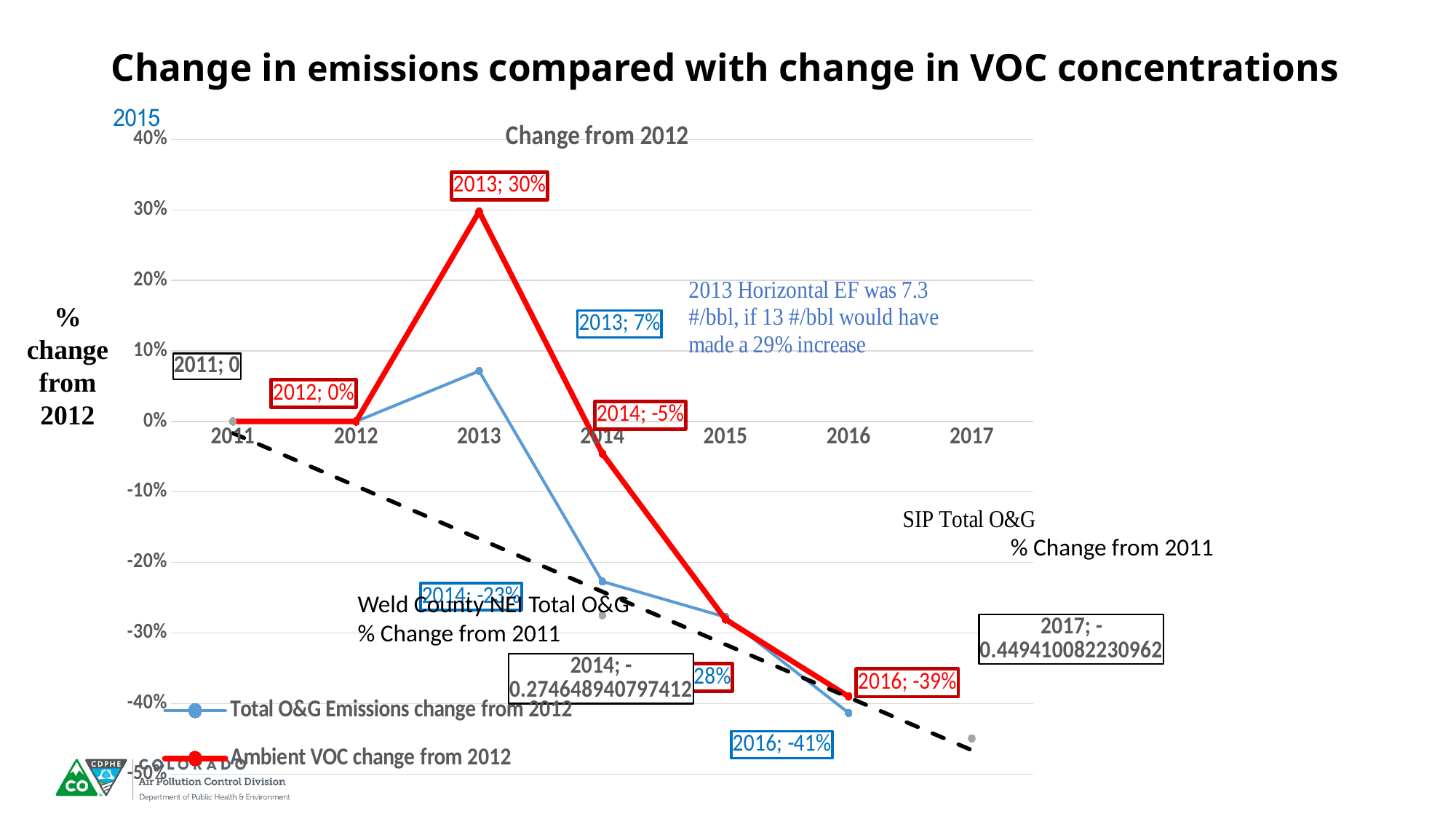
What is the Ambient VOC change from 2012 value for 2014? -5% Does the Ambient VOC change from 2012 series rise or fall from 2013 to 2016? fall What is the Total O&G Emissions change from 2012 value for 2013? 7% Is the Ambient VOC change from 2012 value for 2015 greater or less than -20%? less What is the Ambient VOC change from 2012 value for 2016? -39% What kind of chart is shown on the slide? line chart What is the Total O&G Emissions change from 2012 value for 2016? -41% What is the Ambient VOC change from 2012 value for 2013? 30% In 2013, how many percentage points higher is the Ambient VOC change than the Total O&G Emissions change? 23 percentage points In which year does the Ambient VOC change from 2012 series reach its highest value? 2013 What is the Total O&G Emissions change from 2012 value for 2014? -23% How many series does the chart legend list? 2